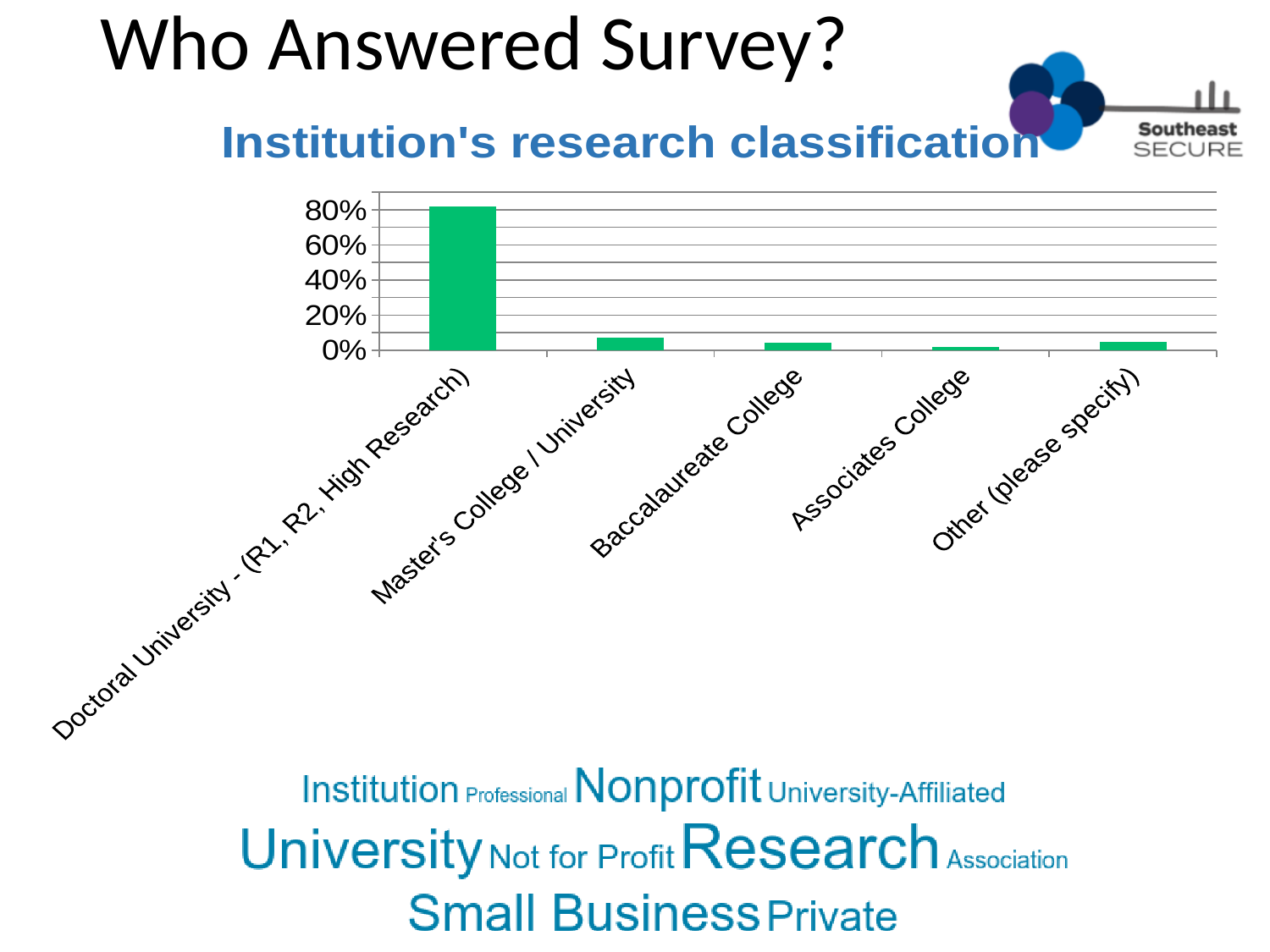
What is the title of the chart? Institution's research classification Is the value for Master's College / University greater or less than 20%? less Which is larger, the value for Doctoral University - (R1, R2, High Research) or the value for Master's College / University? Doctoral University - (R1, R2, High Research) What colour are the bars in the chart? green Which category has the highest value in the chart? Doctoral University - (R1, R2, High Research) Which is larger, the value for Other (please specify) or the value for Associates College? Other (please specify) Which is larger, the value for Master's College / University or the value for Associates College? Master's College / University Is the value for Other (please specify) greater or less than 20%? less How many categories are shown on the x axis of the chart? 5 Which category has the lowest value in the chart? Associates College What type of chart is shown on the slide? bar chart Is the value for Doctoral University - (R1, R2, High Research) greater or less than 60%? greater